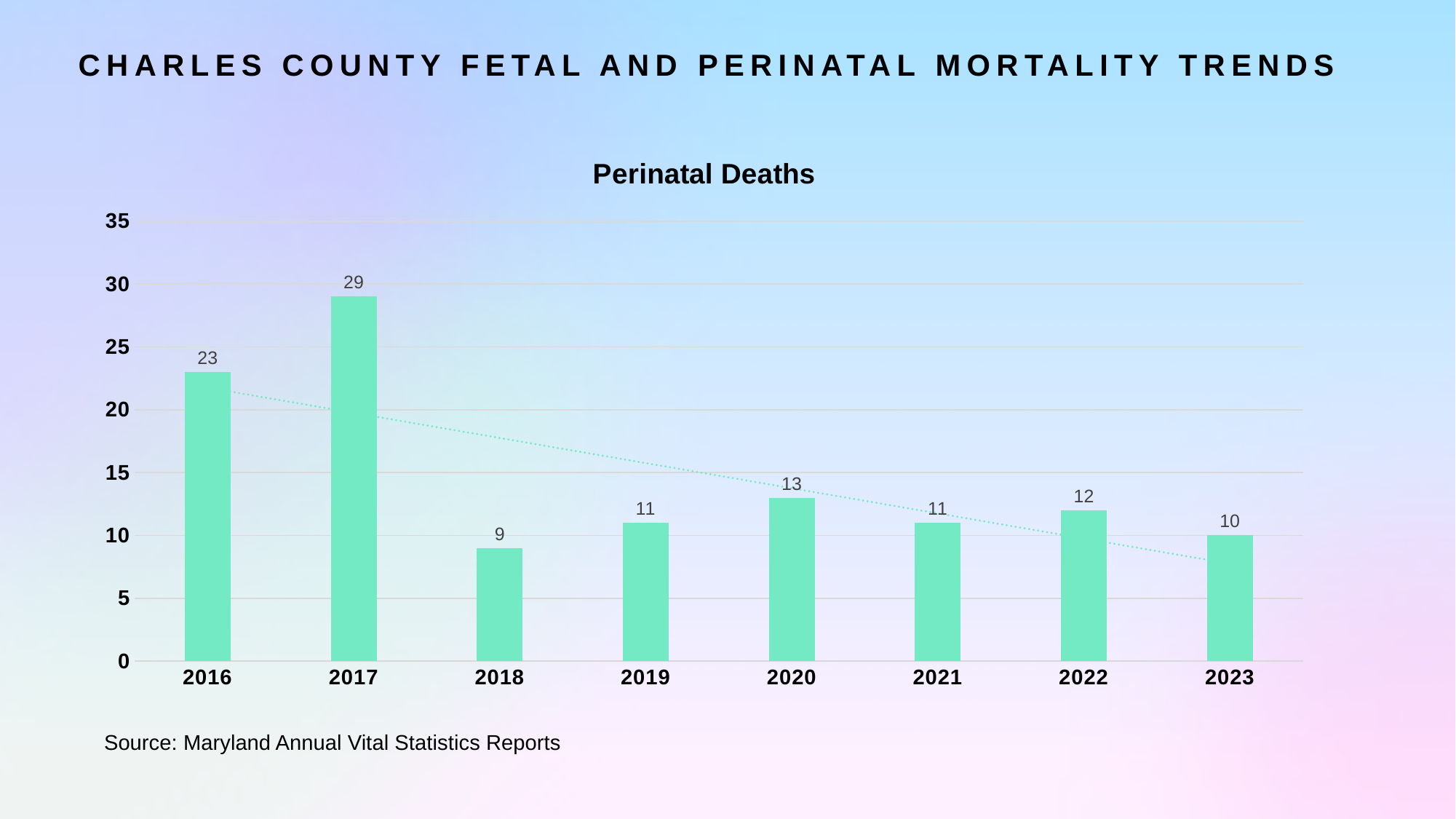
Is the value for 2016 greater or less than 20? greater What is the number of perinatal deaths in 2020? 13 What is the number of perinatal deaths in 2017? 29 Which year has the highest number of perinatal deaths? 2017 What is the number of perinatal deaths in 2023? 10 Which year had more perinatal deaths, 2020 or 2021? 2020 What is the title of the chart? Perinatal Deaths What is the difference in perinatal deaths between 2017 and 2016? 6 How many years are shown on the x axis? 8 What is the difference in perinatal deaths between 2022 and 2023? 2 What kind of chart is shown on the slide? bar chart Which year has the lowest number of perinatal deaths? 2018